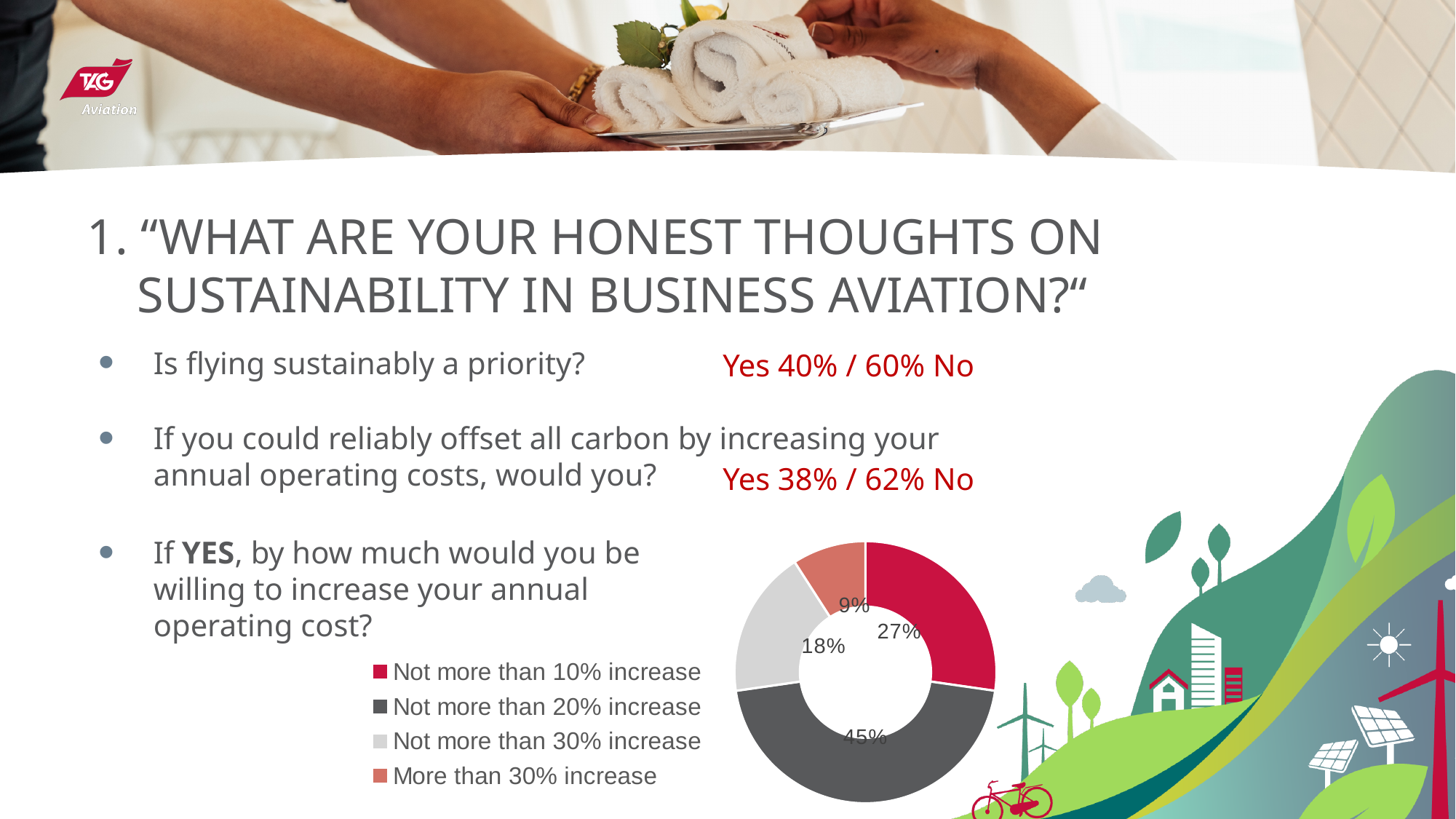
What kind of chart is shown on the slide? Doughnut chart What is the combined share of "Not more than 10% increase" and "Not more than 20% increase"? 72% Which category has the smallest share of the doughnut chart? More than 30% increase Which is larger: the share for "Not more than 30% increase" or the share for "More than 30% increase"? Not more than 30% increase What share of respondents chose "More than 30% increase"? 9% What colour is the slice for "Not more than 10% increase"? Red What share of respondents chose "Not more than 10% increase"? 27% What share of respondents chose "Not more than 30% increase"? 18% Which category has the largest share of the doughnut chart? Not more than 20% increase How many categories does the doughnut chart show? 4 What share of respondents chose "Not more than 20% increase"? 45% What is the difference in percentage points between "Not more than 20% increase" and "Not more than 10% increase"? 18